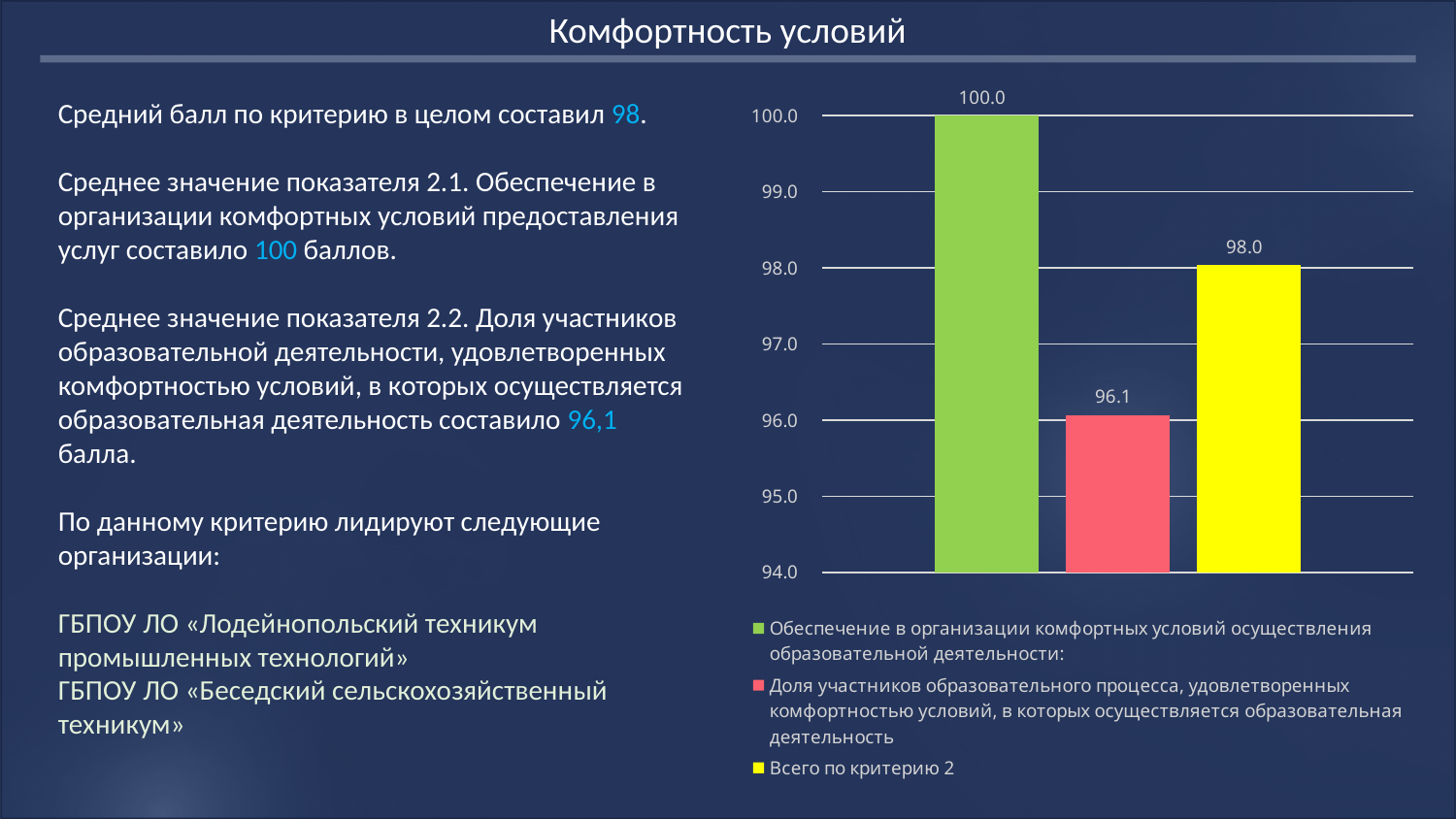
Which series has the lowest value in the chart? Доля участников образовательного процесса, удовлетворенных комфортностью условий, в которых осуществляется образовательная деятельность What value is shown for the series "Всего по критерию 2"? 98.0 What value is shown for the series "Доля участников образовательного процесса, удовлетворенных комфортностью условий, в которых осуществляется образовательная деятельность"? 96.1 How many series does the chart legend list? 3 Which is larger: the value for "Всего по критерию 2" or the value for "Доля участников образовательного процесса, удовлетворенных комфортностью условий..."? Всего по критерию 2 What type of chart is shown on the slide? bar chart Is the value for "Доля участников образовательного процесса, удовлетворенных комфортностью условий..." greater or less than 97.0? less What is the difference between the value for "Обеспечение в организации комфортных условий осуществления образовательной деятельности" and the value for "Всего по критерию 2"? 2.0 What is the difference between the value for "Всего по критерию 2" and the value for "Доля участников образовательного процесса, удовлетворенных комфортностью условий..."? 1.9 How many bars are plotted in the chart? 3 Which series has the highest value in the chart? Обеспечение в организации комфортных условий осуществления образовательной деятельности What value is shown for the series "Обеспечение в организации комфортных условий осуществления образовательной деятельности"? 100.0